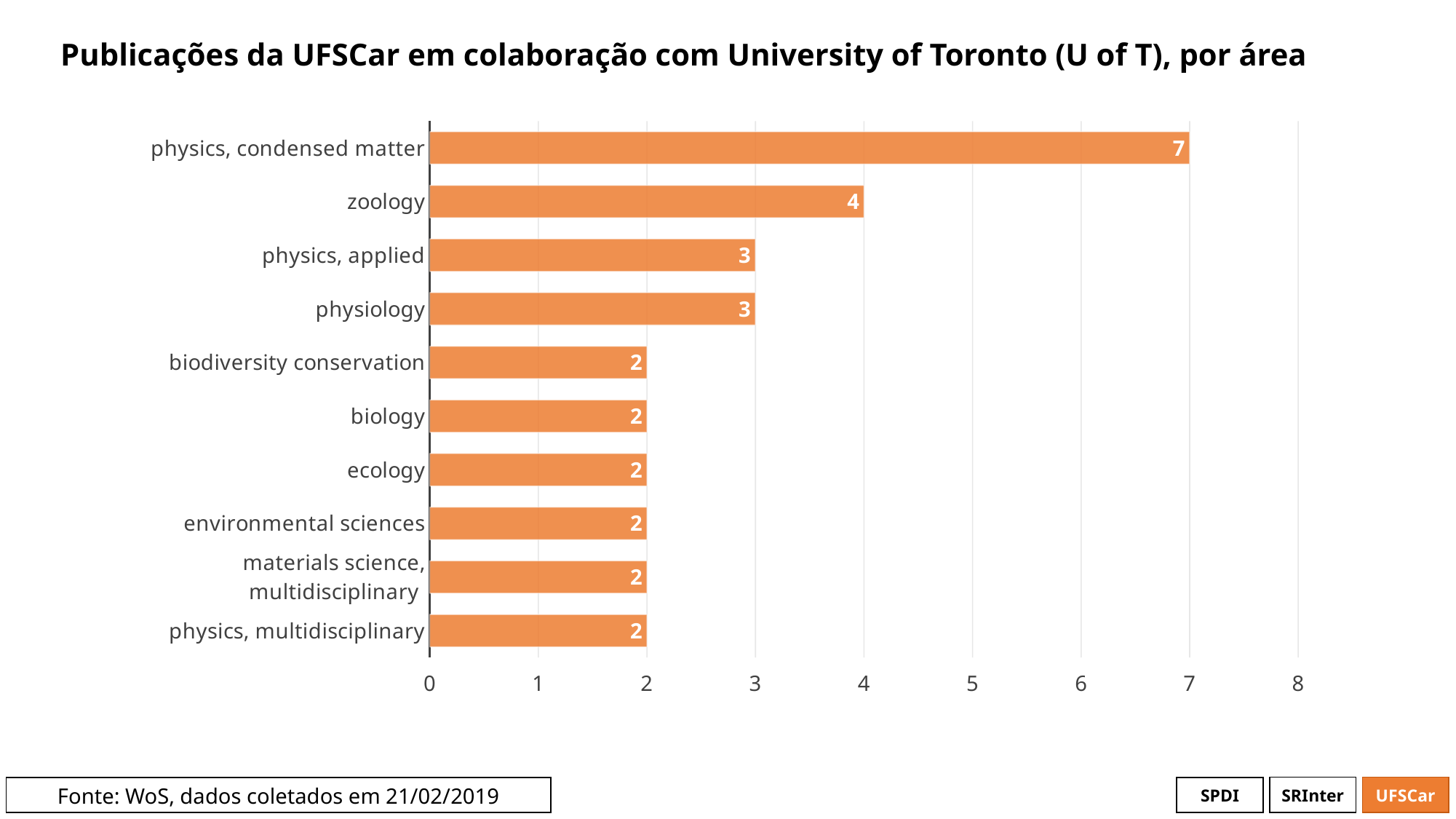
Which area has the highest number of publications? physics, condensed matter What kind of chart is shown on the slide? bar chart What is the difference between the values for zoology and physics, applied? 1 What is the title of the chart? Publicações da UFSCar em colaboração com University of Toronto (U of T), por área What is the value for ecology? 2 Which is larger, the value for zoology or the value for physiology? zoology What is the value for physiology? 3 What is the value for zoology? 4 Is the value for physics, condensed matter greater or less than 6? greater What is the difference between the values for physics, condensed matter and zoology? 3 How many areas are shown in the chart? 10 How many publications are shown for physics, condensed matter? 7